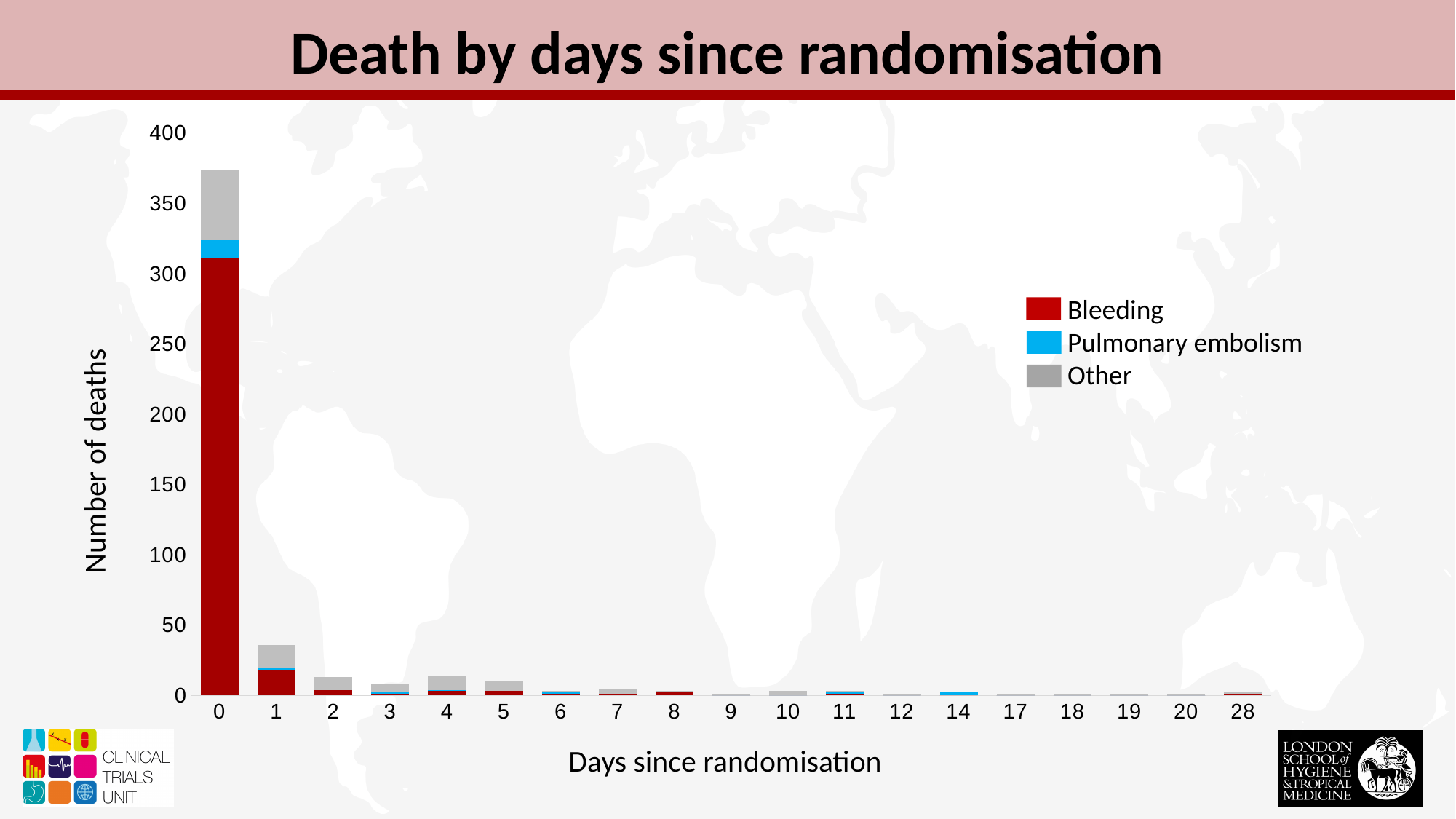
Is the total number of deaths on day 1 greater or less than 50? less Is the total number of deaths on day 0 greater or less than 350? greater How many series does the legend list? 3 Is the number of deaths from bleeding on day 0 greater or less than 250? greater What is the title of the chart? Death by days since randomisation How many day categories are shown on the x axis? 19 Which day since randomisation has the highest number of deaths? 0 What is the label of the y axis? Number of deaths What kind of chart is shown on the slide? Stacked bar chart Which cause of death is shown in red in the legend? Bleeding Do the number of deaths generally rise or fall as days since randomisation increase? Fall Which has more deaths, day 0 or day 1? Day 0